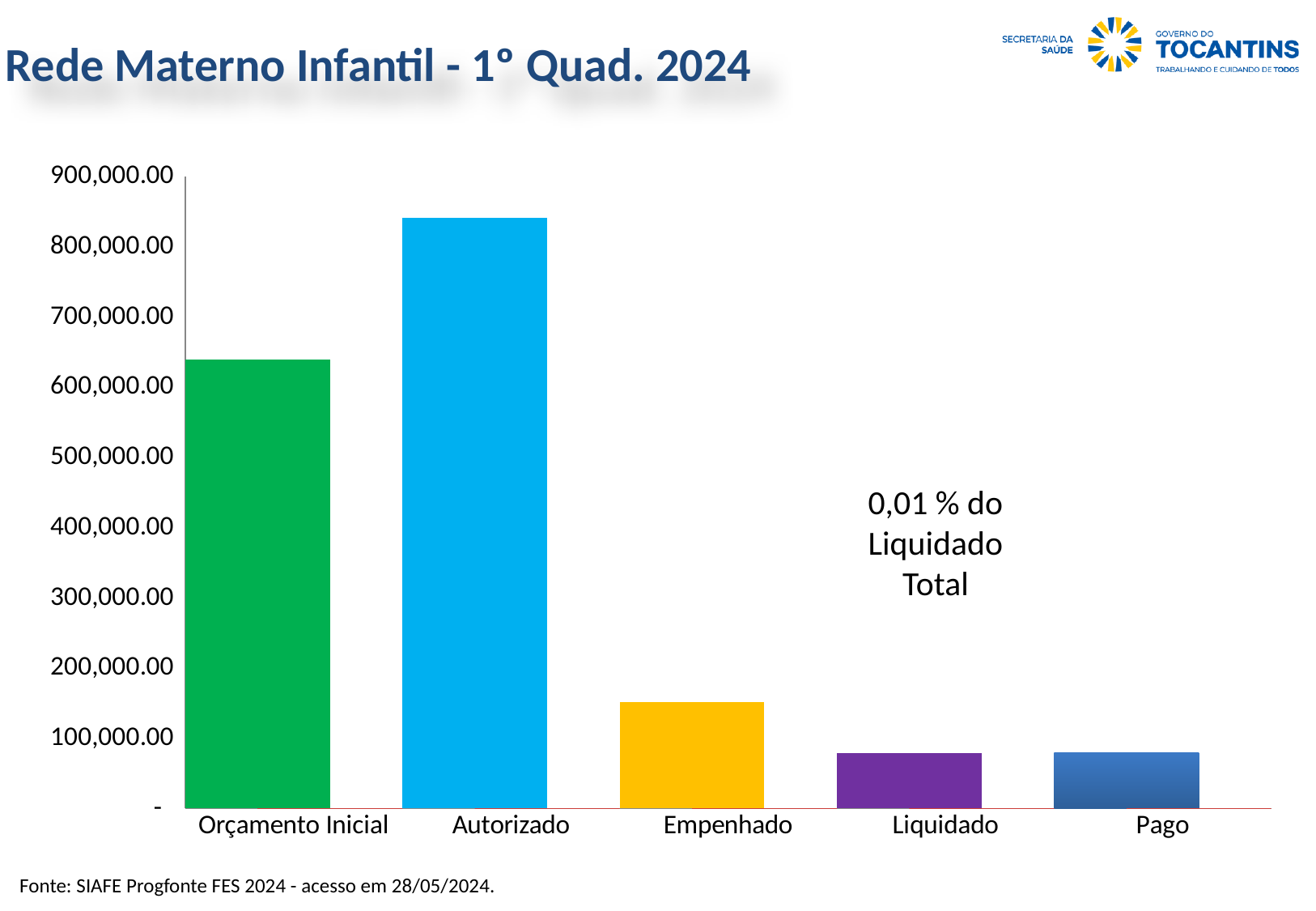
Is the value for Orçamento Inicial greater or less than 600,000.00? greater What percentage is stated in the text annotation inside the chart area? 0,01 % Is the value for Pago greater or less than 100,000.00? less What kind of chart is shown on the slide? bar chart Is the value for Autorizado greater or less than 800,000.00? greater How many categories are shown on the x axis of the chart? 5 Which category has the highest value in the chart? Autorizado Which is larger, the value for Empenhado or the value for Liquidado? Empenhado Which is larger, the value for Autorizado or the value for Orçamento Inicial? Autorizado What is the title of the slide containing the chart? Rede Materno Infantil - 1° Quad. 2024